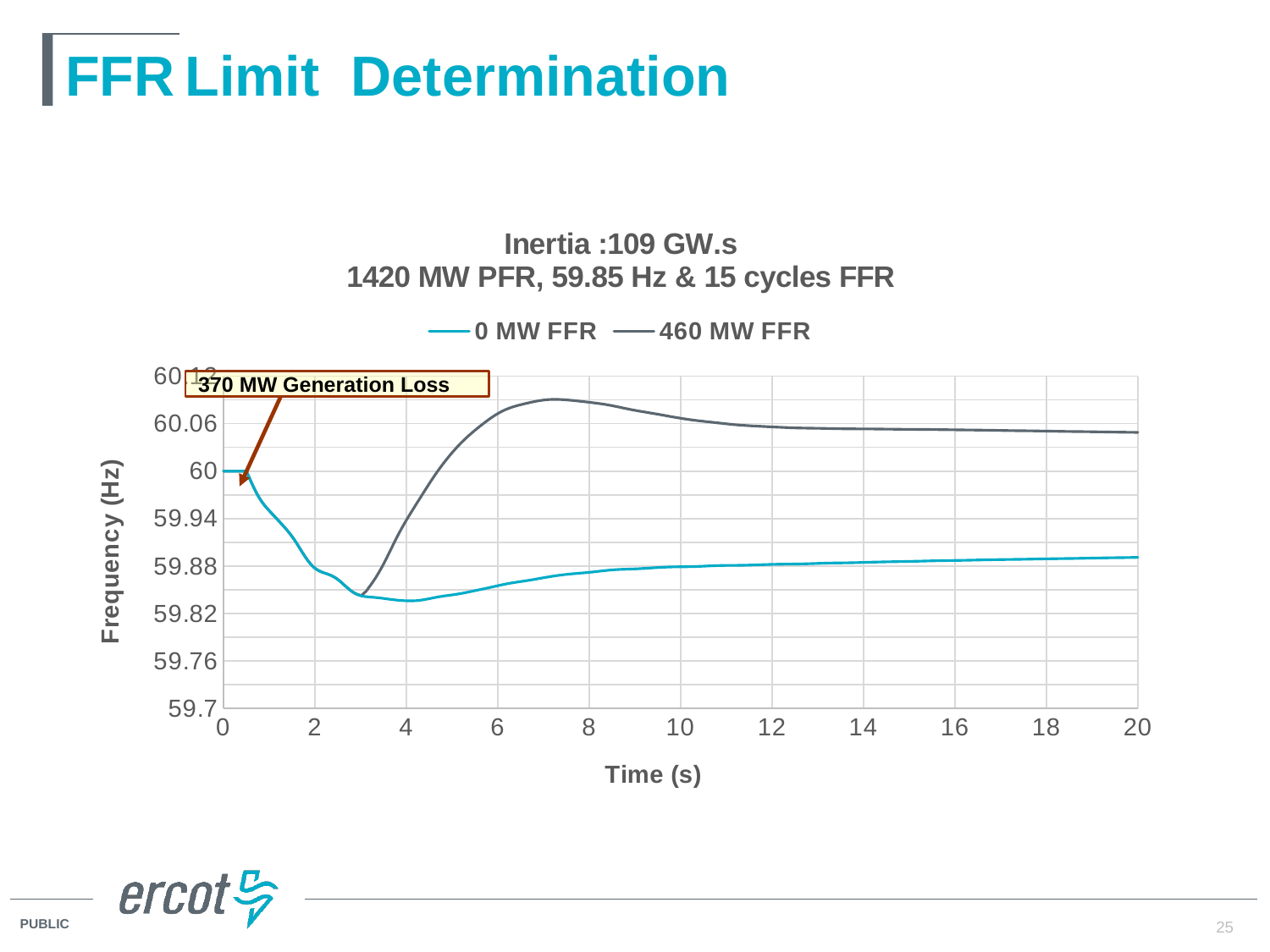
Is the value of the 460 MW FFR series at 7 s greater or less than 60.06? greater Is the value of the 460 MW FFR series at 20 s greater or less than 60? greater How many series does the chart legend list? 2 What kind of chart is shown on the slide? line chart At 10 s, which series has the higher frequency, 0 MW FFR or 460 MW FFR? 460 MW FFR Is the value of the 0 MW FFR series at 20 s greater or less than 60? less What is the label of the chart's y-axis? Frequency (Hz) Between 0 s and 3 s, does the 460 MW FFR series rise or fall? fall What frequency value do both series start at when time is 0 s? 60 What are the two series named in the chart legend? 0 MW FFR and 460 MW FFR Between 4 s and 20 s, does the 0 MW FFR series rise or fall? rise